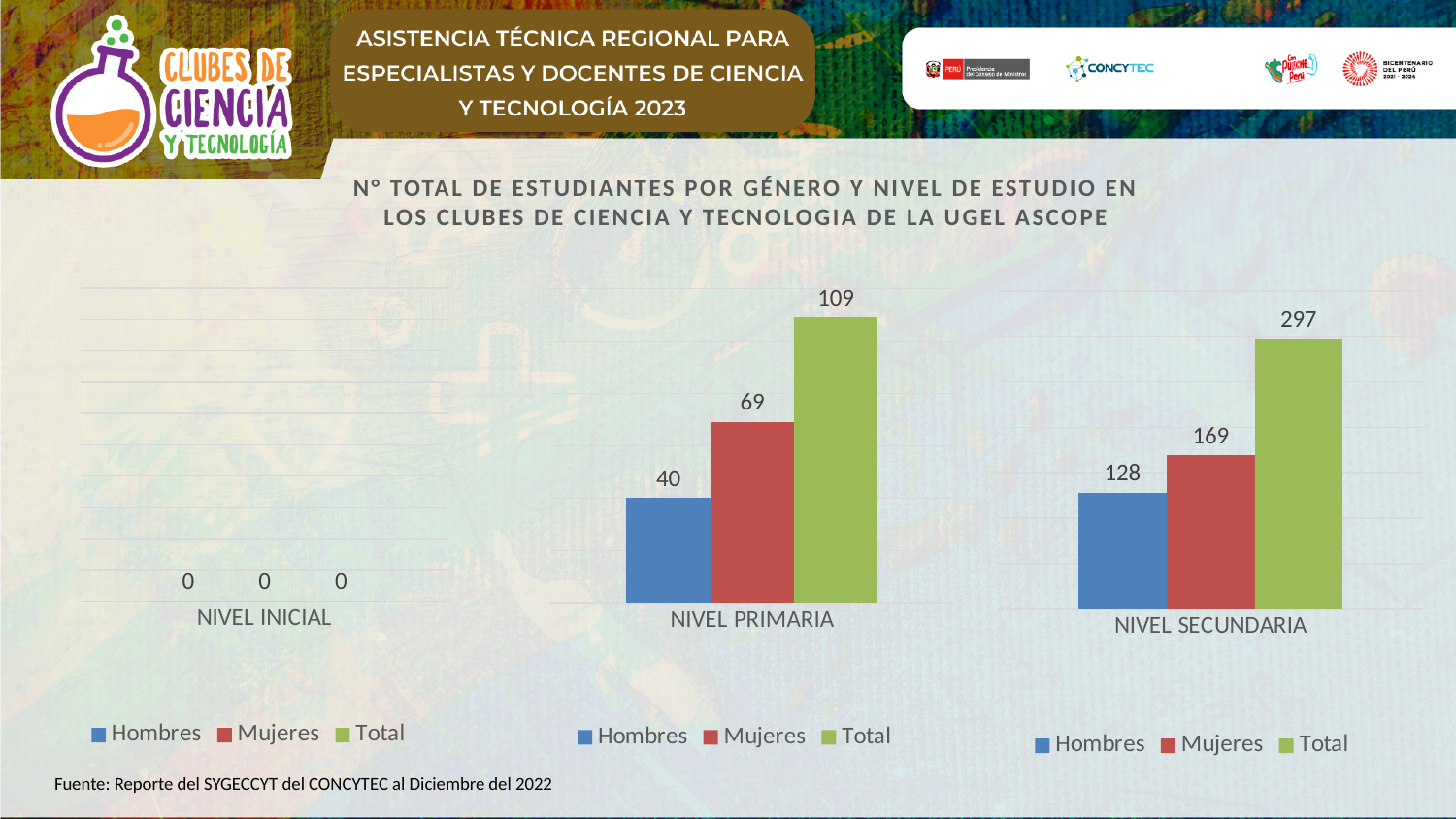
What colour are the Total bars in the charts on this slide? Green In the NIVEL SECUNDARIA chart, which series has the highest value? Total In the NIVEL PRIMARIA chart, which series has the lowest value? Hombres What kind of chart is the NIVEL PRIMARIA chart? Bar chart In the NIVEL SECUNDARIA chart, what is the value for Hombres? 128 In the NIVEL SECUNDARIA chart, what is the difference between Mujeres and Hombres? 41 How many series does the legend of the NIVEL SECUNDARIA chart list? 3 In the NIVEL PRIMARIA chart, what is the value for Mujeres? 69 In the NIVEL PRIMARIA chart, which is larger, Mujeres or Hombres? Mujeres In the NIVEL PRIMARIA chart, what is the value for Hombres? 40 In the NIVEL INICIAL chart, what is the value for Mujeres? 0 In the NIVEL SECUNDARIA chart, what is the value for Total? 297